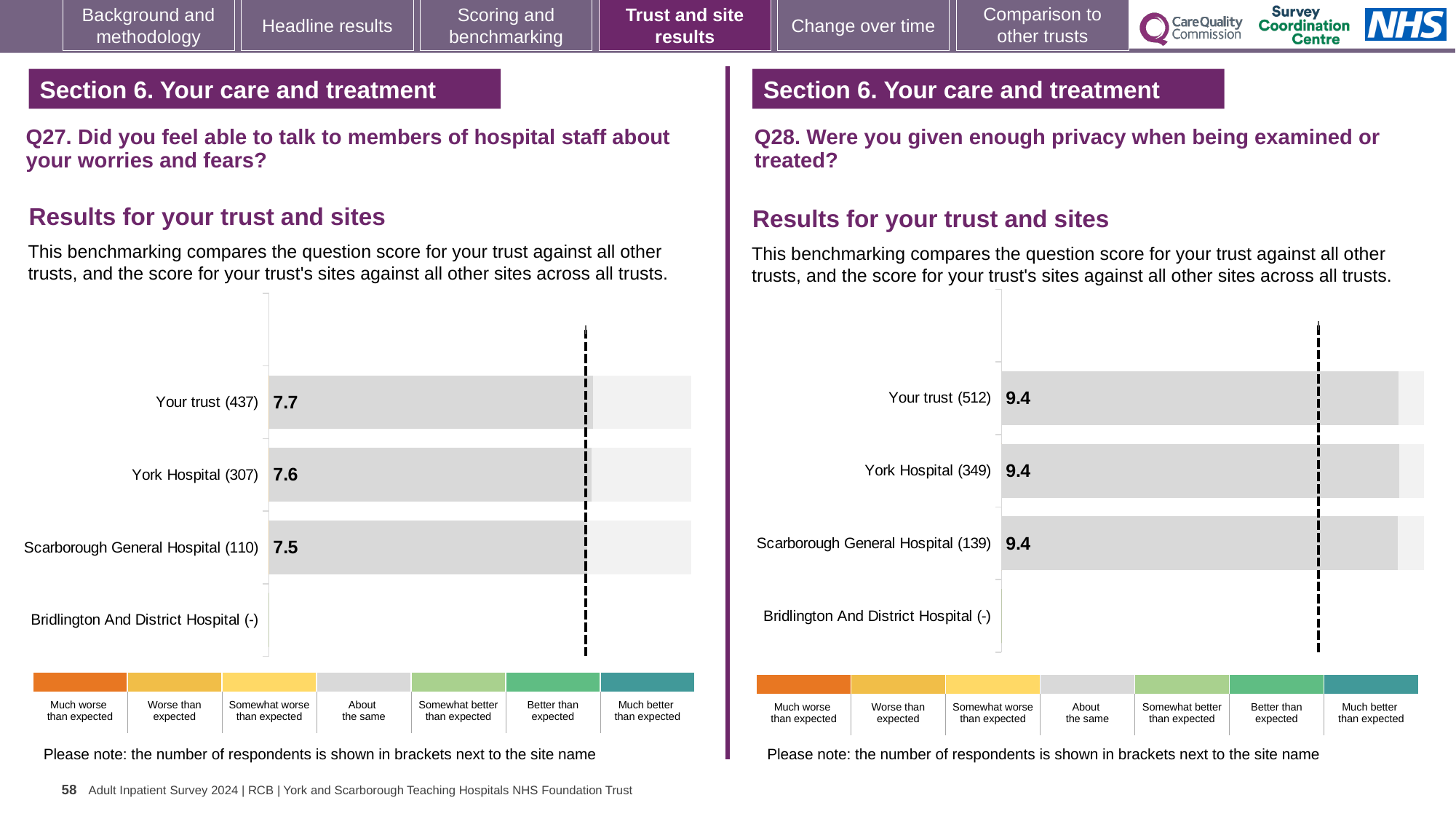
On the Q27 chart (left), which site or trust has the highest score? Your trust (437) On the Q27 chart (left), what is the difference between the score for Your trust and the score for Scarborough General Hospital? 0.2 On the Q28 chart (right), how many respondents are shown in brackets for York Hospital? 349 What type of chart is used on the Q27 chart (left)? Bar chart On the Q27 chart (left), what is the score for Scarborough General Hospital (110)? 7.5 On the Q27 chart (left), which has the larger score, York Hospital or Scarborough General Hospital? York Hospital On the Q28 chart (right), how many sites or trusts are listed on the vertical axis? 4 On the Q28 chart (right), what is the score for Scarborough General Hospital (139)? 9.4 On the Q28 chart (right), what is the score for Your trust (512)? 9.4 On the Q27 chart (left), what is the score for York Hospital (307)? 7.6 On the Q27 chart (left), what is the score for Your trust (437)? 7.7 On the Q27 chart (left), which site or trust has the lowest score among those with a value shown? Scarborough General Hospital (110)